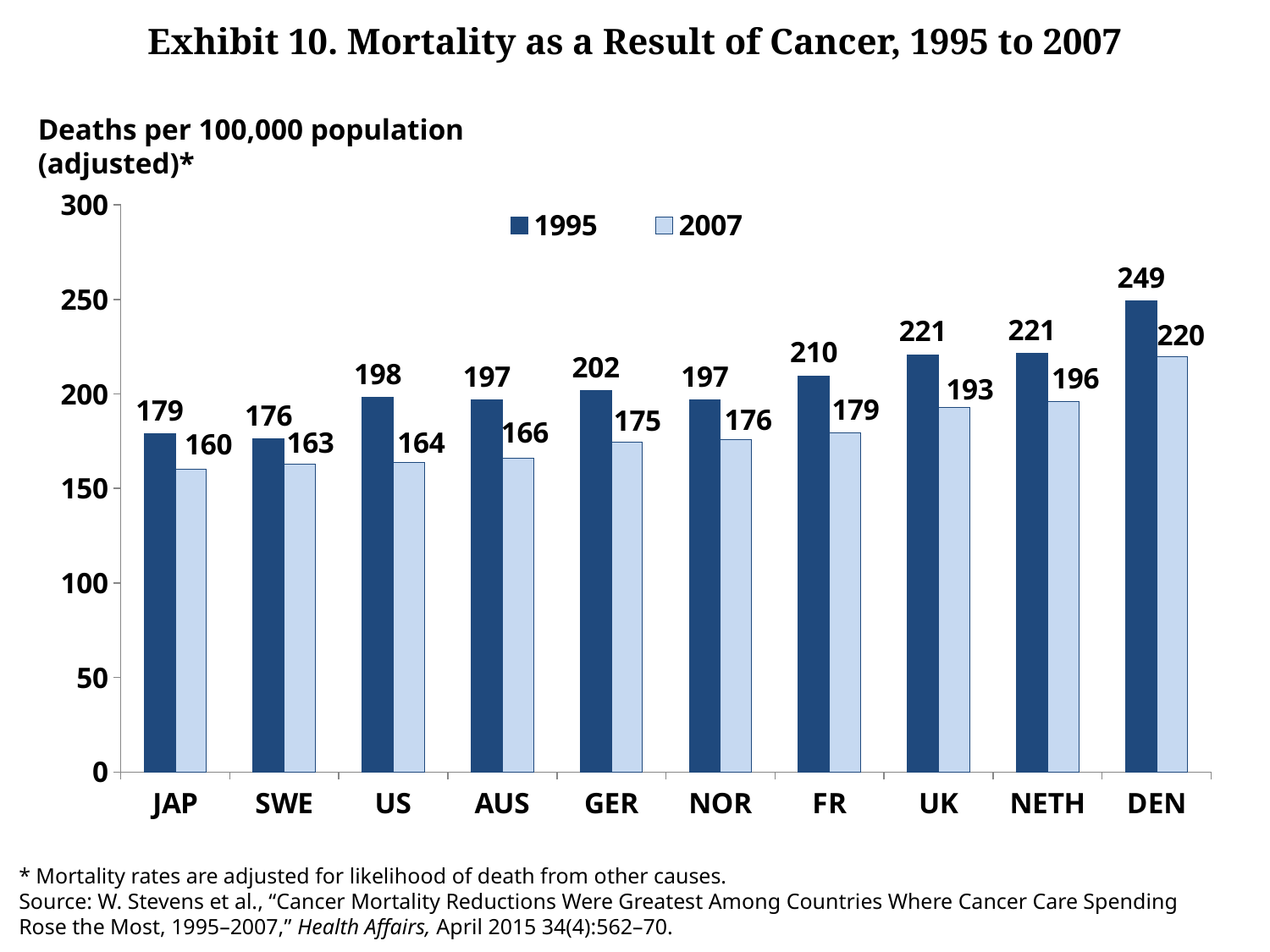
How many countries are shown on the chart? 10 Which was higher in 2007, the cancer mortality rate for France (FR) or for Germany (GER)? FR Which country had the highest cancer mortality rate in 1995? DEN How many series does the legend list? 2 What unit is the y axis measured in, according to the axis label? Deaths per 100,000 population (adjusted)* By how much did Denmark's cancer mortality rate fall from 1995 to 2007? 29 What is the difference between the UK's 1995 and 2007 cancer mortality rates? 28 What was the cancer mortality rate for the Netherlands (NETH) in 2007? 196 Is the 1995 value for Denmark greater or less than 200? greater What was the cancer mortality rate for the US in 1995? 198 Which country had the lowest cancer mortality rate in 2007? JAP What type of chart is shown on the slide? Bar chart